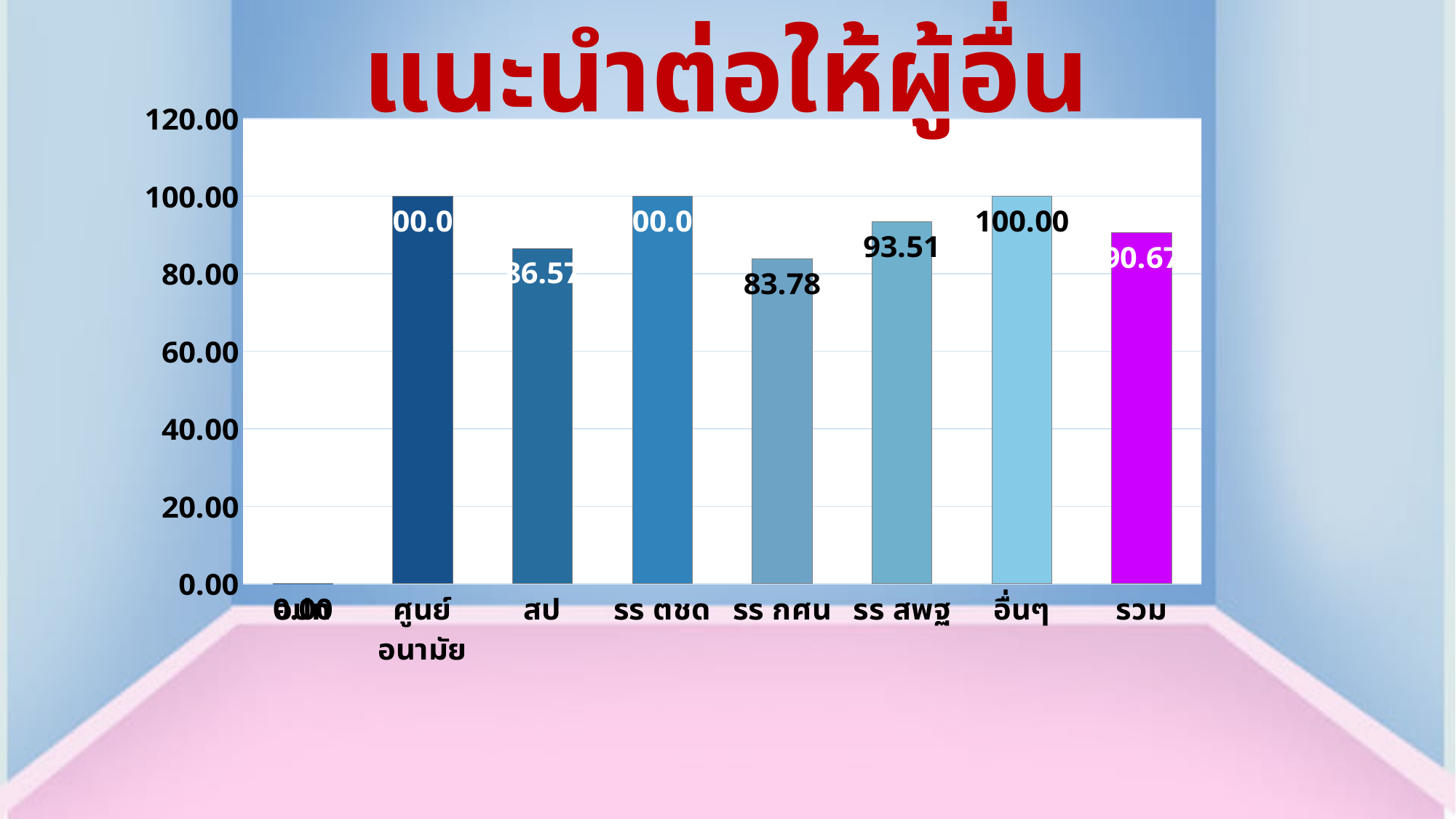
What is the value for รร สพฐ? 93.51 What is the value for อื่นๆ? 100.00 Is the value for สป greater or less than 80.00? greater Is the value for รร กศน greater or less than 100.00? less What is the title of the chart? แนะนำต่อให้ผู้อื่น What colour is the bar for รวม? magenta What is the value for รร กศน? 83.78 How many bars are plotted in the chart? 8 What is the difference between the values for รร สพฐ and รร กศน? 9.73 Which is larger, the value for รร สพฐ or the value for รร กศน? รร สพฐ What kind of chart is shown on the slide? bar chart Is the value for รวม greater or less than 100.00? less